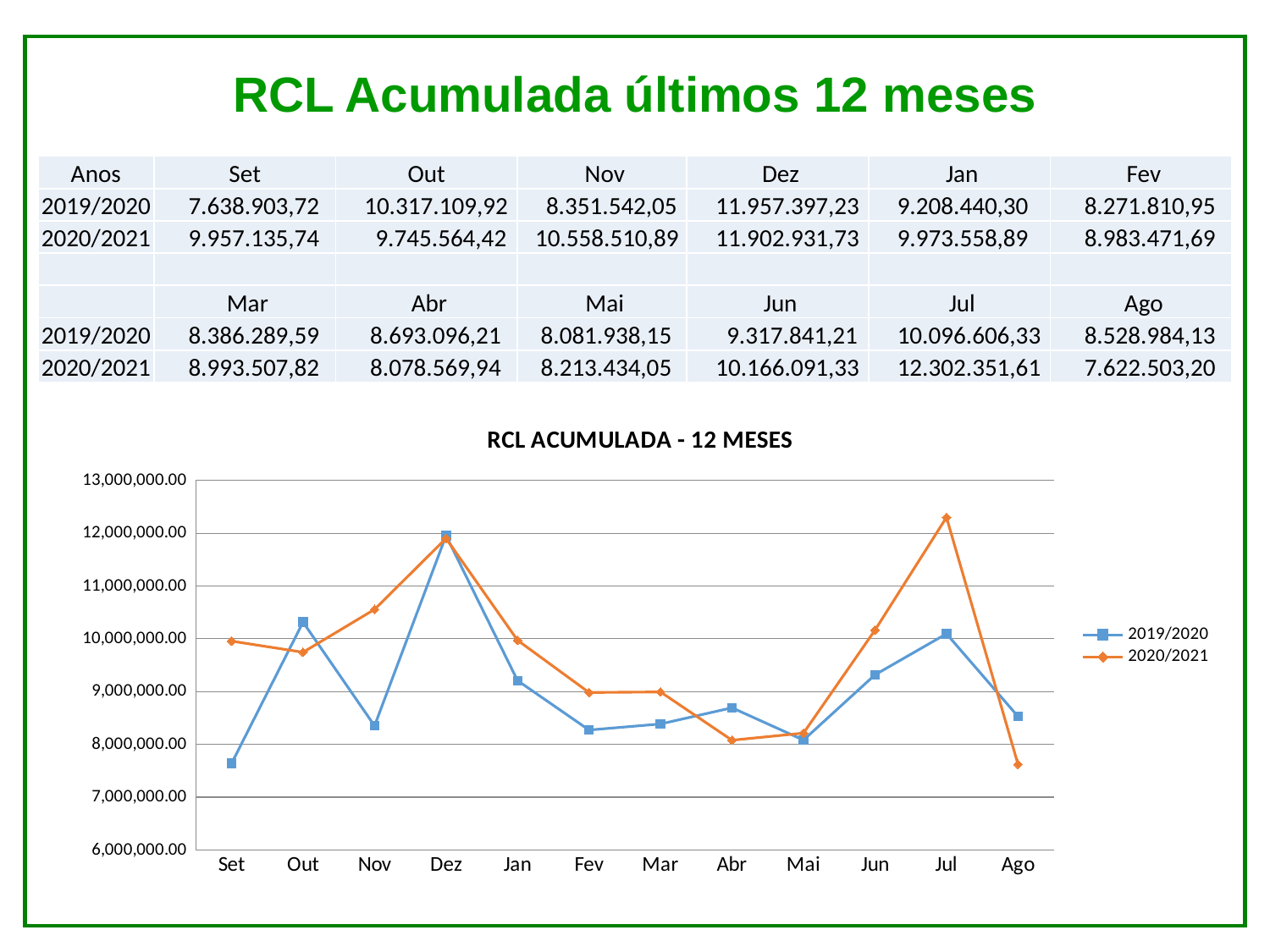
How many months are plotted along the x axis of the chart? 12 What is the difference between the 2019/2020 and 2020/2021 values in Ago? 906.480,93 What is the value for 2020/2021 in Jul? 12.302.351,61 In which month does the 2020/2021 series reach its highest value? Jul In which month does the 2020/2021 series have its lowest value? Ago Is the value for 2019/2020 in Dez greater or less than 11,000,000.00? greater In Nov, which series has the larger value, 2019/2020 or 2020/2021? 2020/2021 How many series does the chart legend list? 2 What is the value for 2019/2020 in Dez? 11.957.397,23 What kind of chart is shown on the slide? line chart Does the 2020/2021 series rise or fall from Jul to Ago? fall In which month does the 2019/2020 series have its lowest value? Set